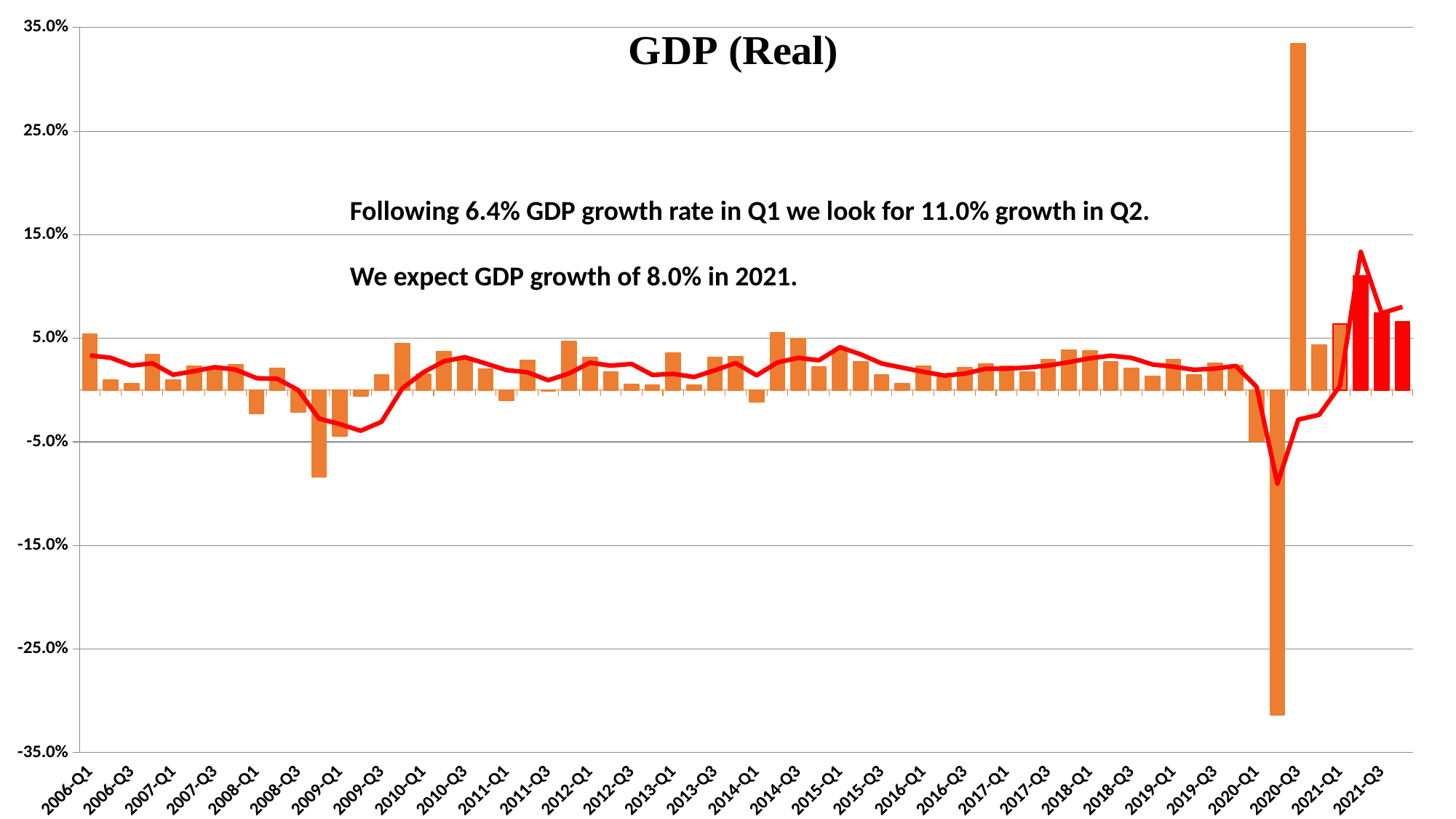
Which bar is higher, 2006-Q1 or 2020-Q3? 2020-Q3 Which quarter has the lowest bar in the GDP (Real) chart? 2020-Q2 What is the title of the chart? GDP (Real) Is the value for 2020-Q3 greater or less than 25.0%? greater What type of chart is shown on the slide? Bar chart with a line Which quarter has the highest bar in the GDP (Real) chart? 2020-Q3 According to the text on the chart, what GDP growth is expected in 2021? 8.0% Does the red line rise or fall from 2020-Q2 to 2021-Q2? rise Is the value for 2020-Q2 greater or less than -25.0%? less Is the value for 2021-Q2 greater or less than 5.0%? greater Which bar is lower, 2009-Q1 or 2020-Q2? 2020-Q2